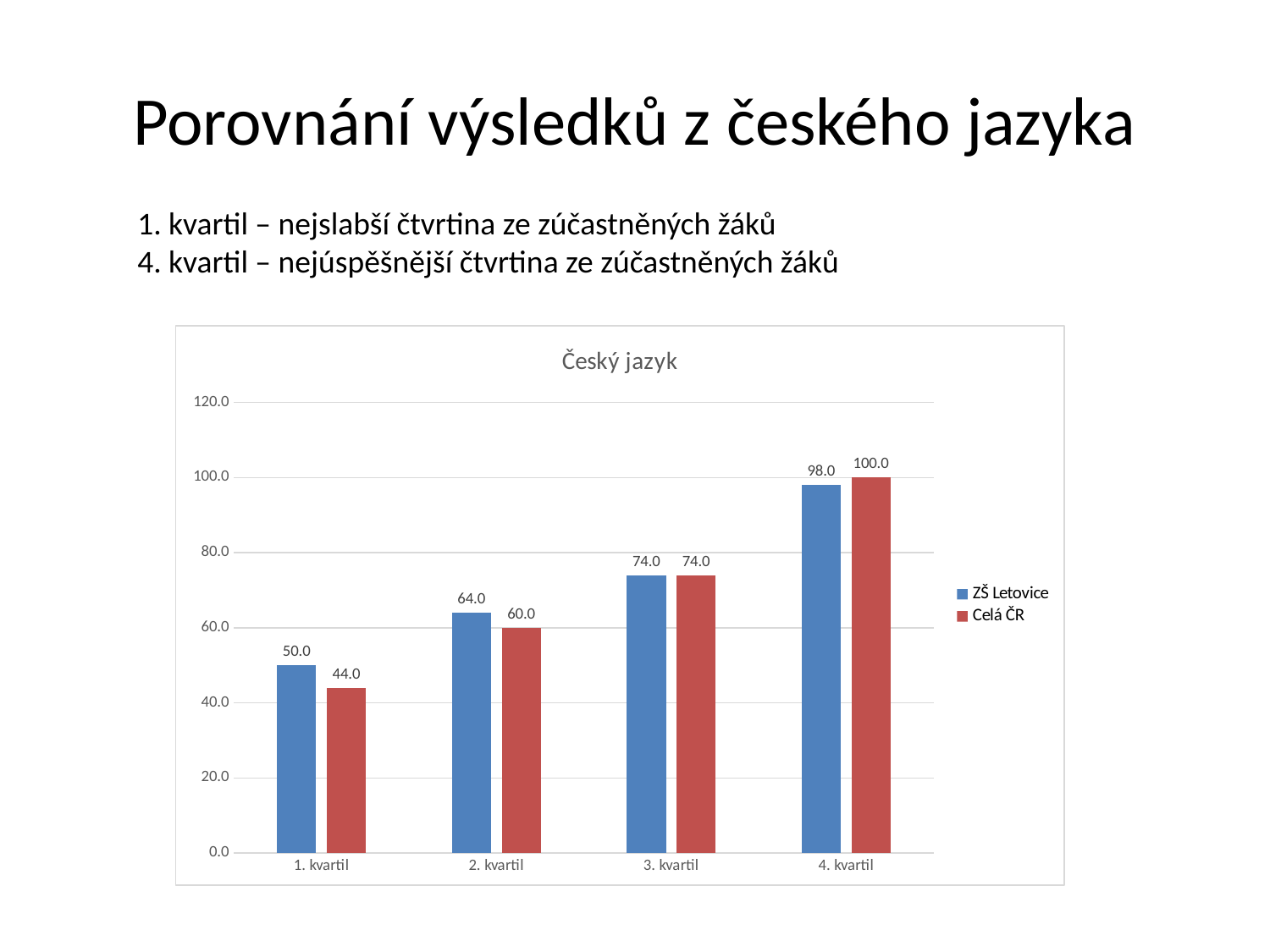
What is the value for Celá ČR in 4. kvartil? 100.0 How many categories are shown on the x axis? 4 Which category has the highest value for ZŠ Letovice? 4. kvartil What is the title of the chart? Český jazyk What is the difference between ZŠ Letovice and Celá ČR in 1. kvartil? 6.0 Do the values for Celá ČR rise or fall from 1. kvartil to 4. kvartil? Rise What is the value for ZŠ Letovice in 1. kvartil? 50.0 What is the value for Celá ČR in 2. kvartil? 60.0 Which is larger in 2. kvartil, ZŠ Letovice or Celá ČR? ZŠ Letovice How many series does the legend list? 2 Which category has the lowest value for Celá ČR? 1. kvartil What kind of chart is shown on the slide? Bar chart